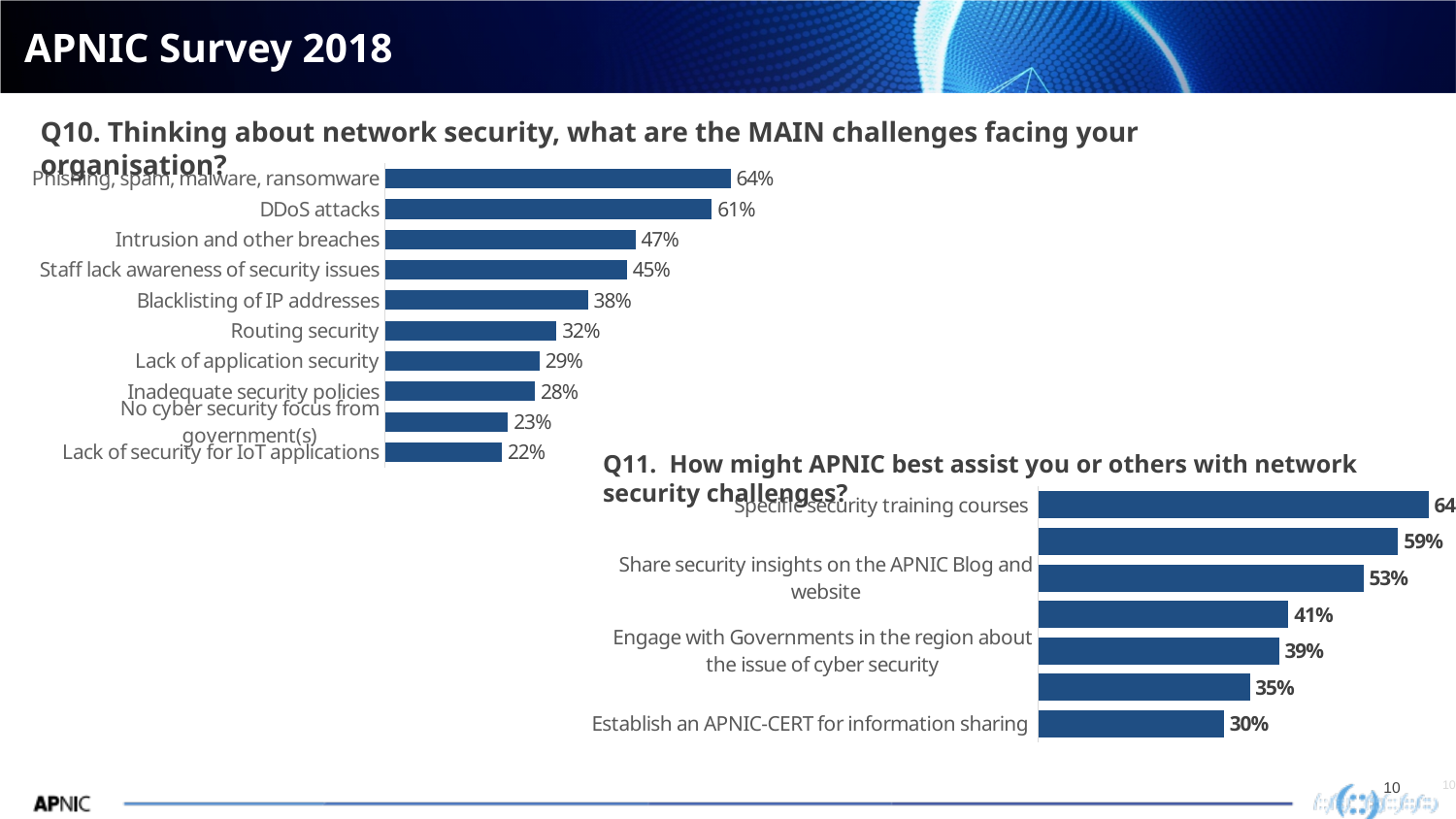
In the Q11 chart, what percentage is shown for Establish an APNIC-CERT for information sharing? 30% In the Q10 chart, what is the difference between the percentages for Intrusion and other breaches and Routing security? 15% In the Q11 chart, which option has the highest value? Specific security training courses In the Q10 chart, which challenge has the highest percentage? Phishing, spam, malware, ransomware In the Q10 chart, what percentage is shown for DDoS attacks? 61% How many bars are shown in the Q11 chart? 7 What type of chart is used for Q10? Bar chart In the Q10 chart, which is larger: Staff lack awareness of security issues or Lack of application security? Staff lack awareness of security issues In the Q10 chart, what percentage is shown for Blacklisting of IP addresses? 38% In the Q10 chart, which challenge has the lowest percentage? Lack of security for IoT applications How many challenges are listed in the Q10 chart? 10 In the Q10 chart, what percentage is shown for Inadequate security policies? 28%